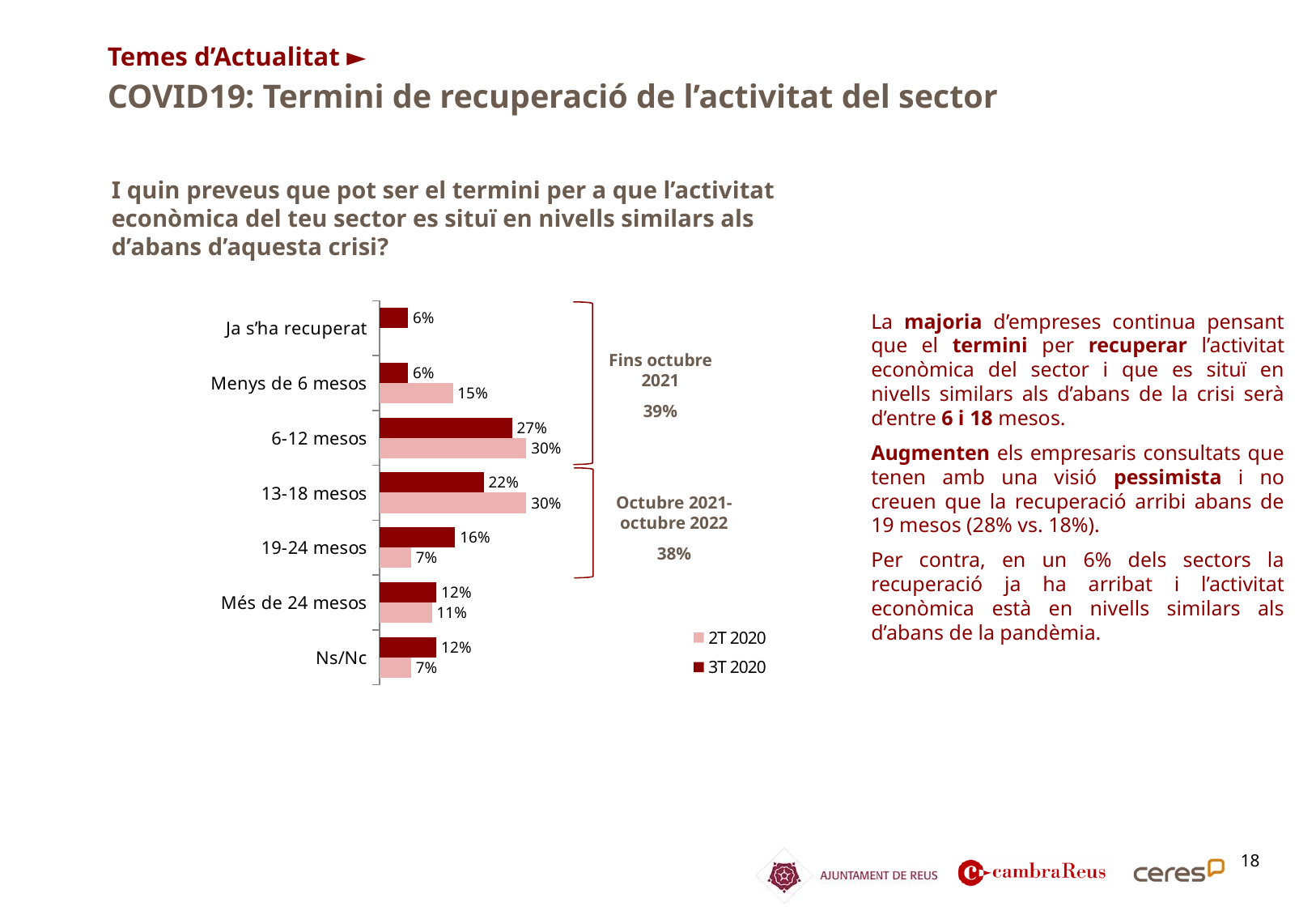
What kind of chart is shown on the slide? Bar chart How many series does the legend list? 2 How many categories are shown on the chart? 7 For "Ns/Nc", which series has the larger value, 2T 2020 or 3T 2020? 3T 2020 What is the difference between the 2T 2020 and 3T 2020 values for "13-18 mesos"? 8% For "Menys de 6 mesos", which series has the larger value, 2T 2020 or 3T 2020? 2T 2020 What is the difference between the 2T 2020 and 3T 2020 values for "19-24 mesos"? 9% What is the 2T 2020 value for "Menys de 6 mesos"? 15% What is the 2T 2020 value for "13-18 mesos"? 30% What is the 3T 2020 value for "6-12 mesos"? 27% Which category has the highest 3T 2020 value? 6-12 mesos What is the 3T 2020 value for "Ja s'ha recuperat"? 6%